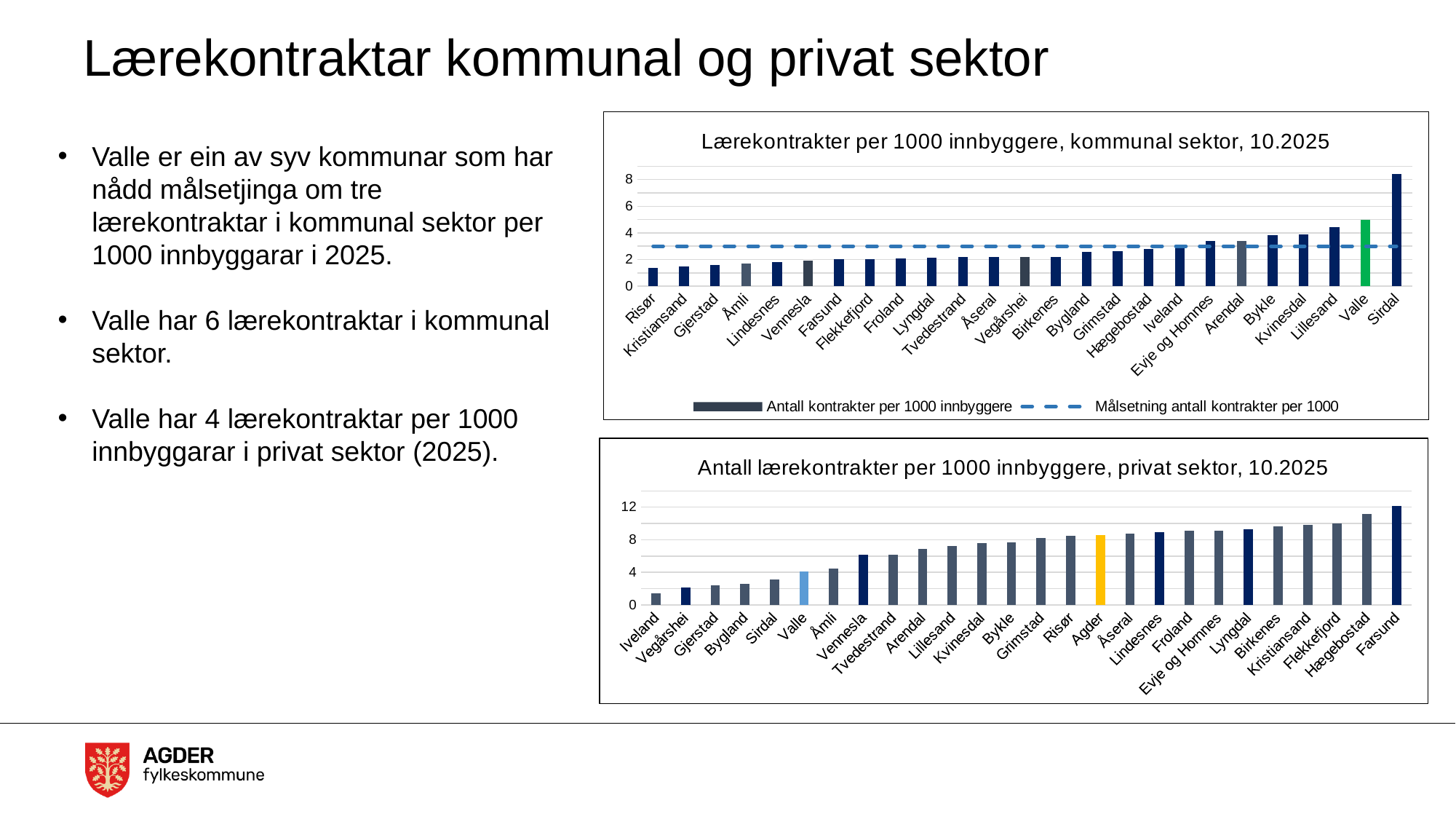
What kind of chart is the top chart, 'Lærekontrakter per 1000 innbyggere, kommunal sektor, 10.2025'? Combination bar and line chart (bars with a dashed target line) In the top chart (kommunal sektor), how many entries does the legend list? 2 In the bottom chart (privat sektor), is the value for Hægebostad greater or less than 8? greater In the top chart (kommunal sektor), which municipality has the highest number of contracts per 1000 inhabitants? Sirdal In the bottom chart (privat sektor), which municipality has the highest value? Farsund In the top chart (kommunal sektor), is the value for Risør greater or less than 2? less In the bottom chart (privat sektor), which municipality has the lowest value? Iveland In the top chart (kommunal sektor), which is larger, the value for Valle or the value for Sirdal? Sirdal In the bottom chart (privat sektor), how many categories are shown on the x axis? 26 In the top chart (kommunal sektor), is the value for Sirdal greater or less than 6? greater In the top chart (kommunal sektor), what colour is the bar for Valle? Green In the bottom chart (privat sektor), do the values rise or fall from left to right along the x axis? Rise